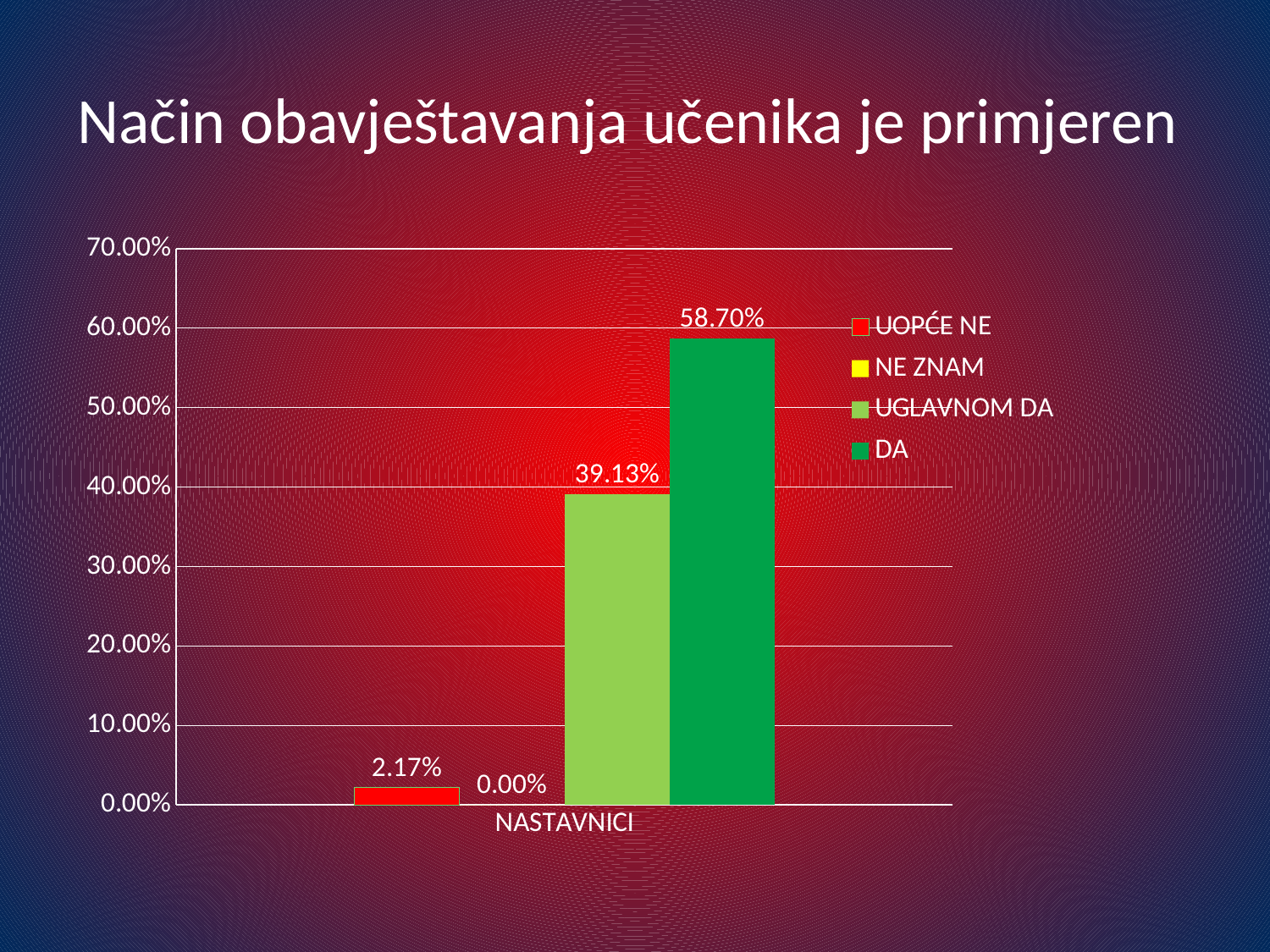
What is the value for UOPĆE NE? 2.17% Which series has the lowest value? NE ZNAM What is the value for DA? 58.70% What is the value for UGLAVNOM DA? 39.13% What kind of chart is shown on the slide? bar chart Which series has the highest value? DA What is the value for NE ZNAM? 0.00% How many series does the legend list? 4 What is the difference between the values for DA and UGLAVNOM DA? 19.57% Which is larger, the value for UGLAVNOM DA or the value for UOPĆE NE? UGLAVNOM DA Is the value for DA greater or less than 50.00%? greater What is the category label on the x axis? NASTAVNICI